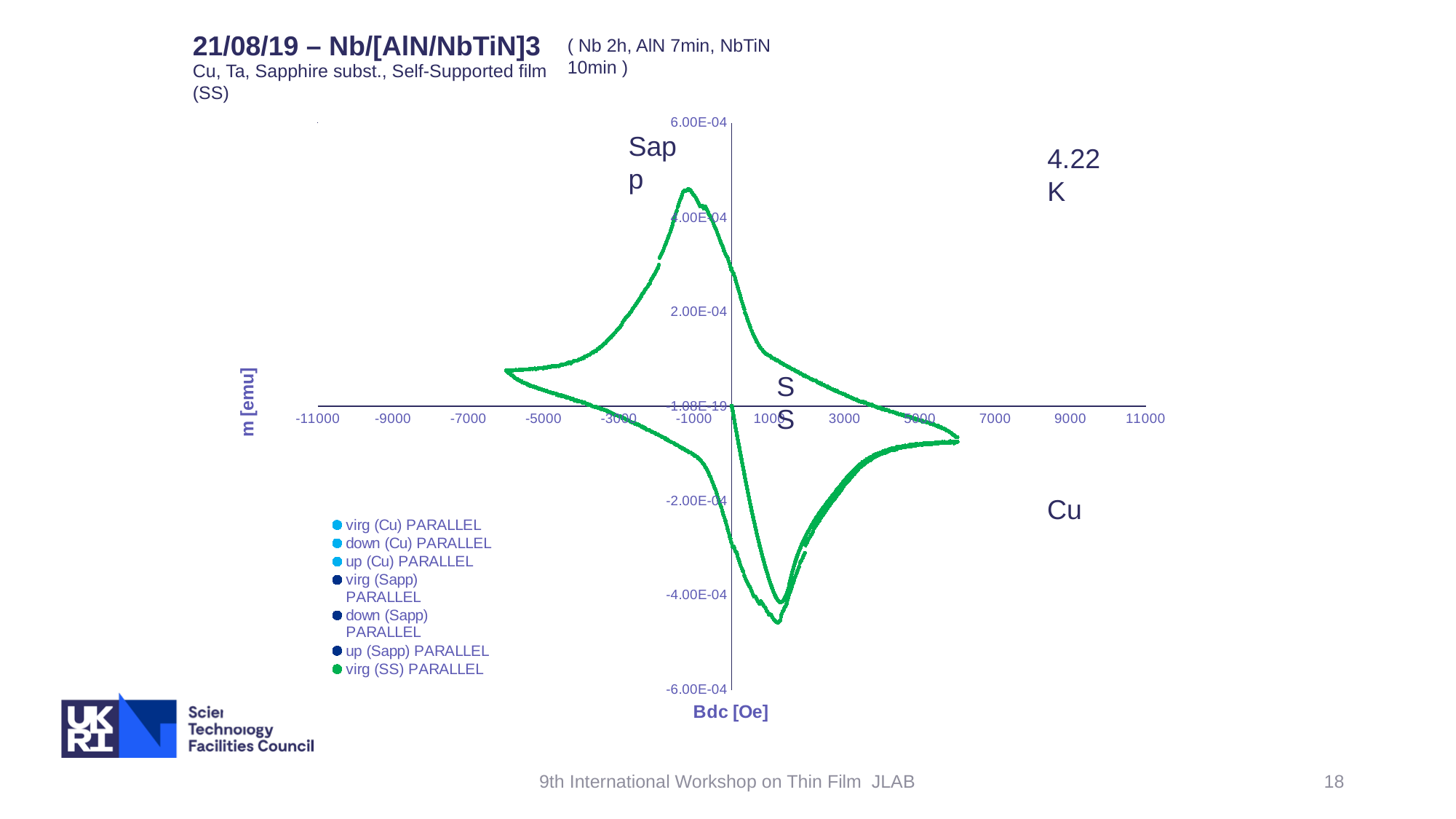
What is the label of the x axis? Bdc [Oe] Is the value of the upper branch of the loop at -5000 Oe greater or less than 2.00E-04? less What is the lowest tick value shown on the x axis? -11000 Is the minimum value of the plotted loop near 1000 Oe greater or less than -4.00E-04? less Is the value of the lower branch of the loop at 5000 Oe greater or less than -2.00E-04? greater What is the label of the y axis? m [emu] What temperature is annotated on the chart? 4.22 K What kind of chart is shown on the slide? scatter chart What is the highest tick value shown on the y axis? 6.00E-04 Which legend entry is plotted in green? virg (SS) PARALLEL How many series does the legend list? 7